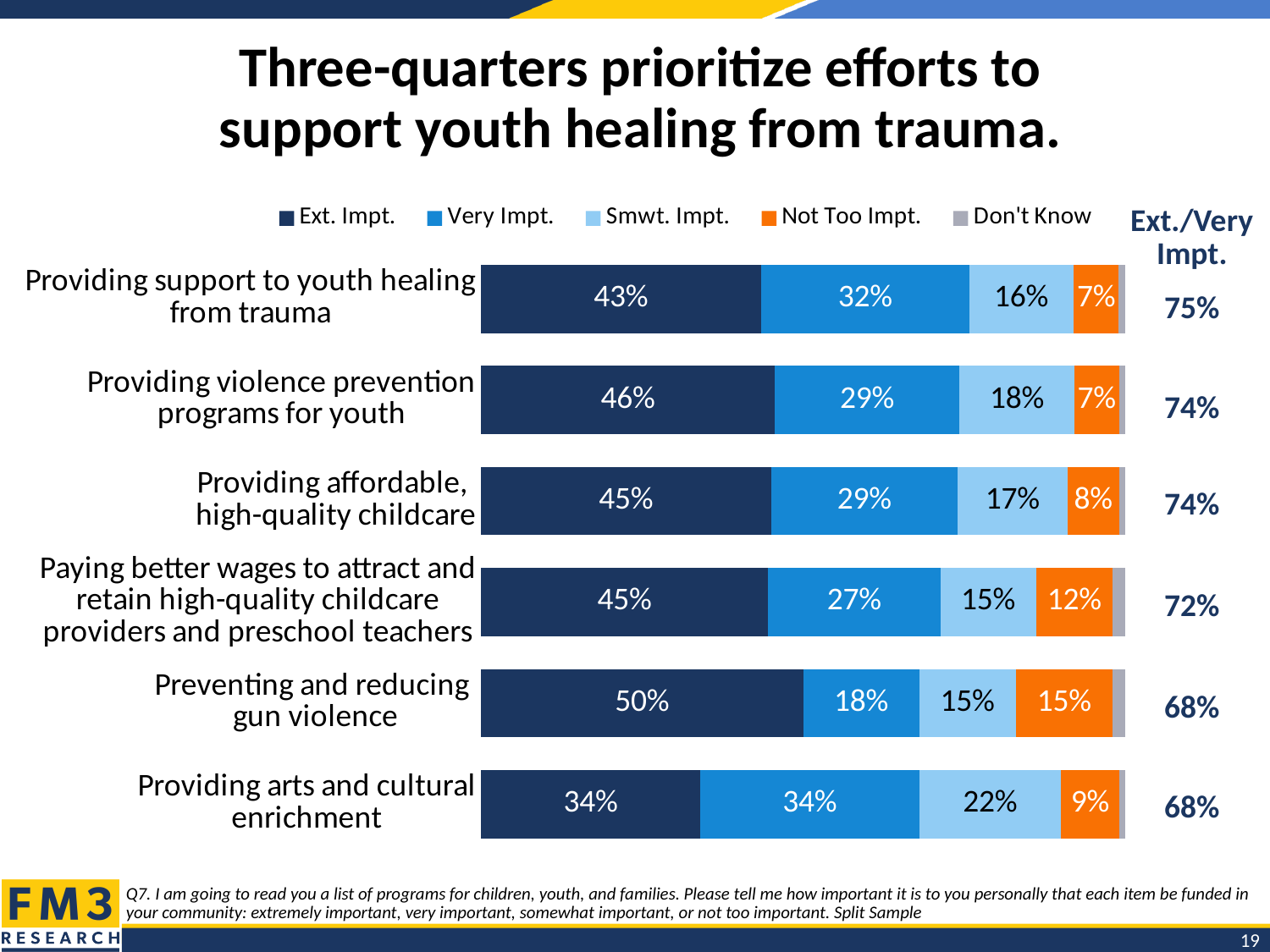
Which item has the lowest Ext. Impt. percentage? Providing arts and cultural enrichment How many response categories does the legend list? 5 What kind of chart is shown on the slide? Stacked bar chart What percentage rated "Preventing and reducing gun violence" as Ext. Impt.? 50% Which item has the highest Ext. Impt. percentage? Preventing and reducing gun violence What is the combined Ext./Very Impt. value for "Providing support to youth healing from trauma"? 75% What is the Not Too Impt. value for "Paying better wages to attract and retain high-quality childcare providers and preschool teachers"? 12% How many program items are shown in the chart? 6 What is the Very Impt. value for "Providing arts and cultural enrichment"? 34% How many percentage points higher is the Ext. Impt. value for "Providing violence prevention programs for youth" than for "Providing support to youth healing from trauma"? 3 percentage points What is the Smwt. Impt. value for "Providing arts and cultural enrichment"? 22% Which has a larger Very Impt. value: "Providing support to youth healing from trauma" or "Preventing and reducing gun violence"? Providing support to youth healing from trauma